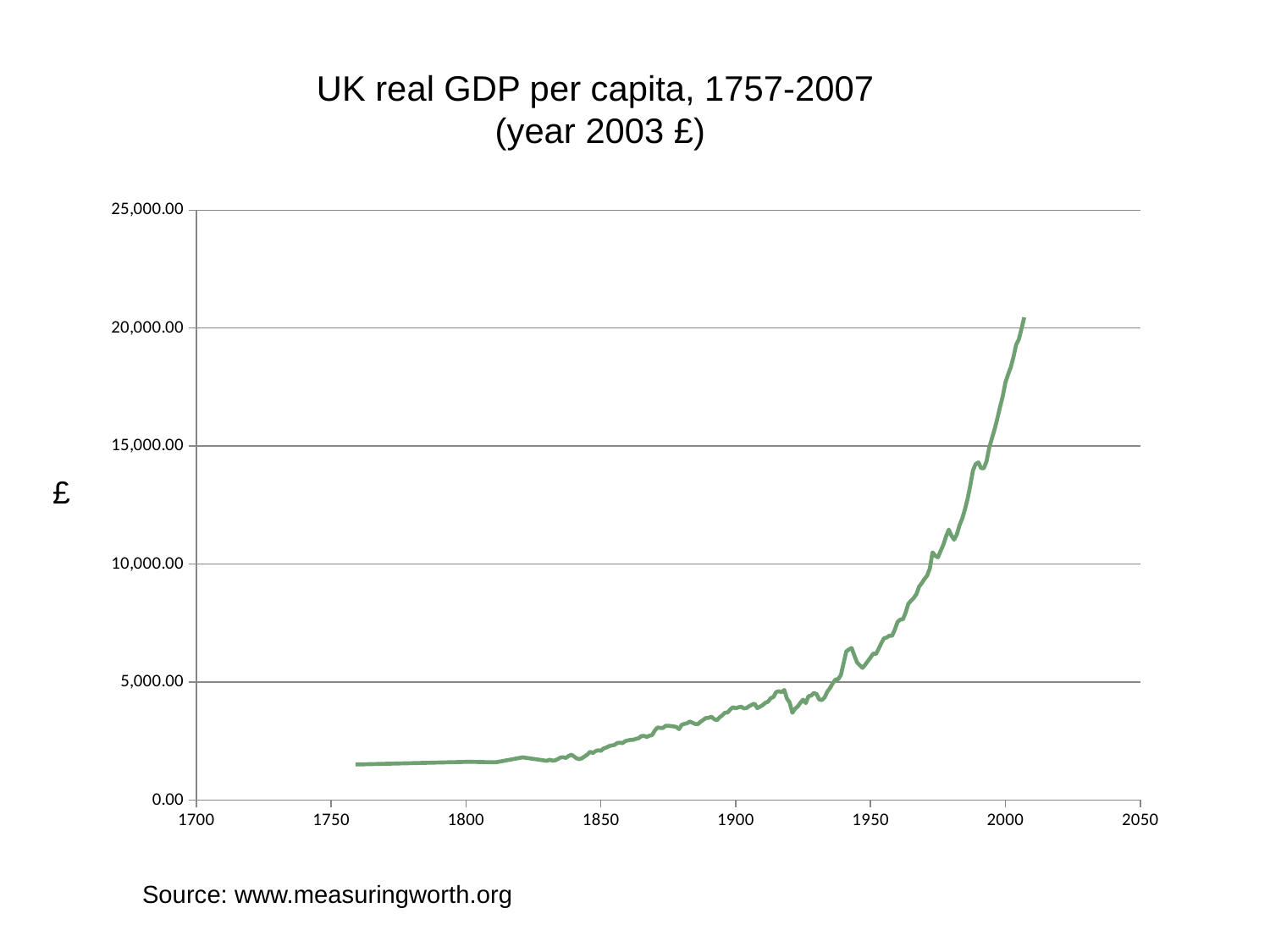
Is the value for 1850 greater or less than 5,000? less Is the value for 1900 greater or less than 5,000? less Is the value for 2000 greater or less than 15,000? greater How many lines are plotted on the chart? 1 Overall, does UK real GDP per capita rise or fall from 1757 to 2007? rise What is the source cited below the chart? www.measuringworth.org What is the title of the chart? UK real GDP per capita, 1757-2007 (year 2003 £) What kind of chart is shown on the slide? line chart Which is larger, the value for 1950 or the value for 1850? 1950 In which year does the line reach its highest value? 2007